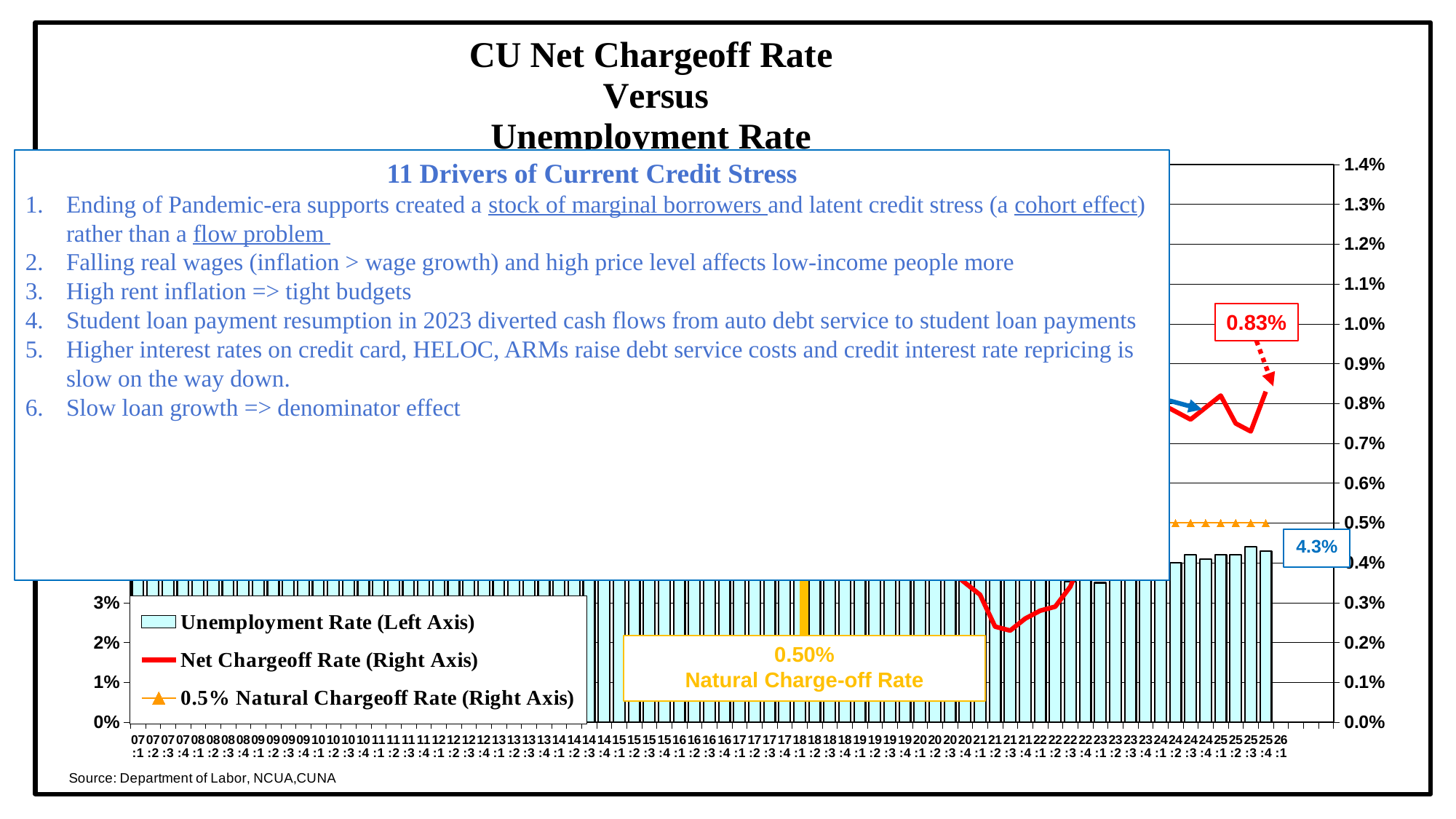
Is the Net Chargeoff Rate in 21:3 greater or less than 0.3% on the right axis? less Which is larger, the latest labelled Net Chargeoff Rate or the Natural Charge-off Rate? Net Chargeoff Rate What is the latest labelled value of the Net Chargeoff Rate? 0.83% Does the Net Chargeoff Rate rise or fall from 21:2 to 22:3? rise How many series does the chart legend list? 3 What is the latest labelled value of the Unemployment Rate? 4.3% What value is given for the Natural Charge-off Rate? 0.50% Is the Unemployment Rate in 25:4 greater or less than 3% on the left axis? greater On which axis is the Unemployment Rate plotted? Left axis What is the title of the chart? CU Net Chargeoff Rate Versus Unemployment Rate By how much does the latest labelled Net Chargeoff Rate (0.83%) exceed the Natural Charge-off Rate (0.50%)? 0.33% What kind of chart is this? Combined bar and line chart